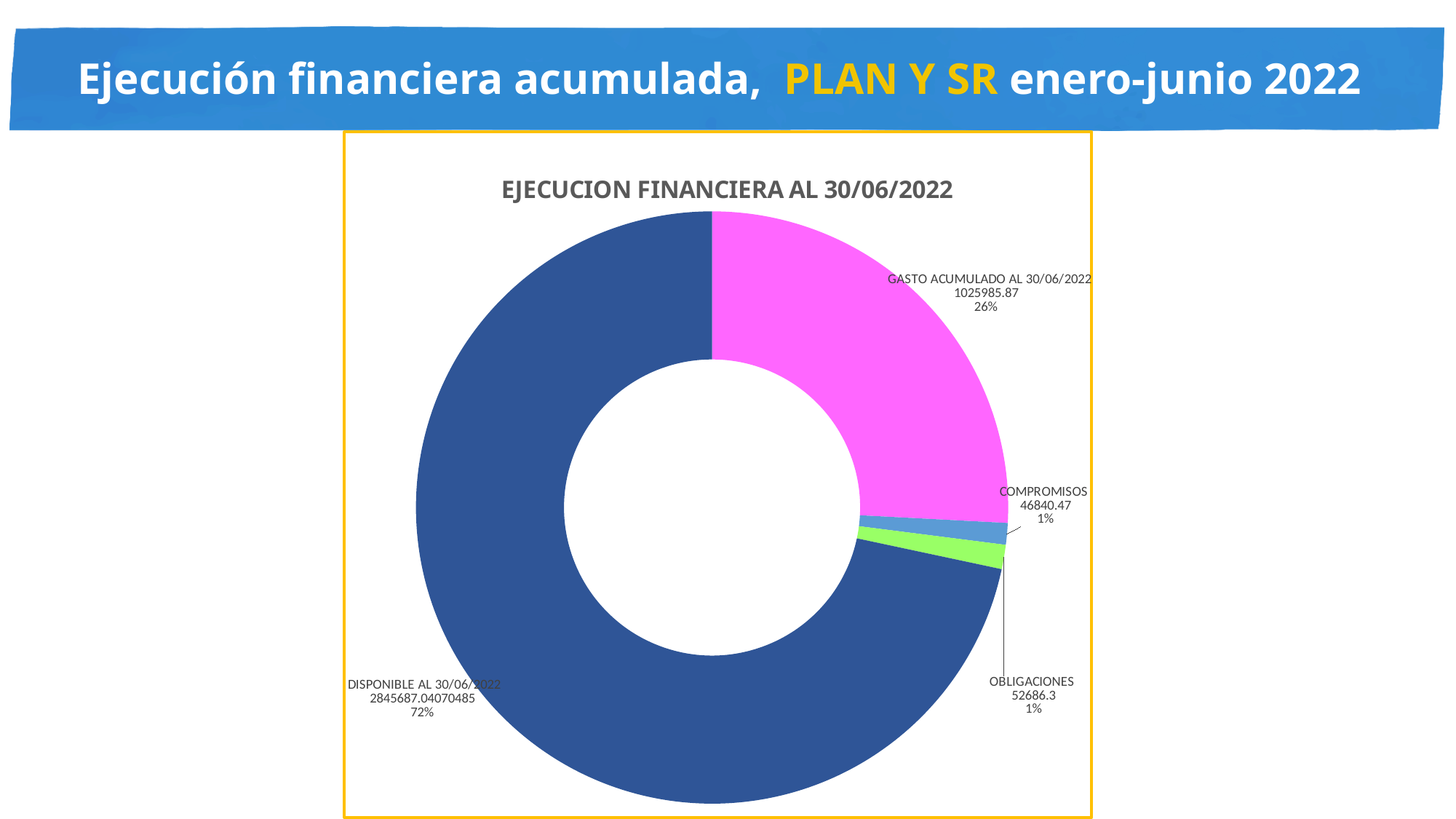
What is the value for DISPONIBLE AL 30/06/2022? 2845687.04070485 What is the difference between the values for OBLIGACIONES and COMPROMISOS? 5845.83 What is the title of the chart? EJECUCION FINANCIERA AL 30/06/2022 How many slices does the chart have? 4 What is the value for OBLIGACIONES? 52686.3 Which is larger, OBLIGACIONES or COMPROMISOS? OBLIGACIONES What kind of chart is shown on the slide? doughnut chart Which category has the largest slice? DISPONIBLE AL 30/06/2022 What is the value for GASTO ACUMULADO AL 30/06/2022? 1025985.87 What share of the chart does DISPONIBLE AL 30/06/2022 represent? 72% What share of the chart does GASTO ACUMULADO AL 30/06/2022 represent? 26% What is the value for COMPROMISOS? 46840.47